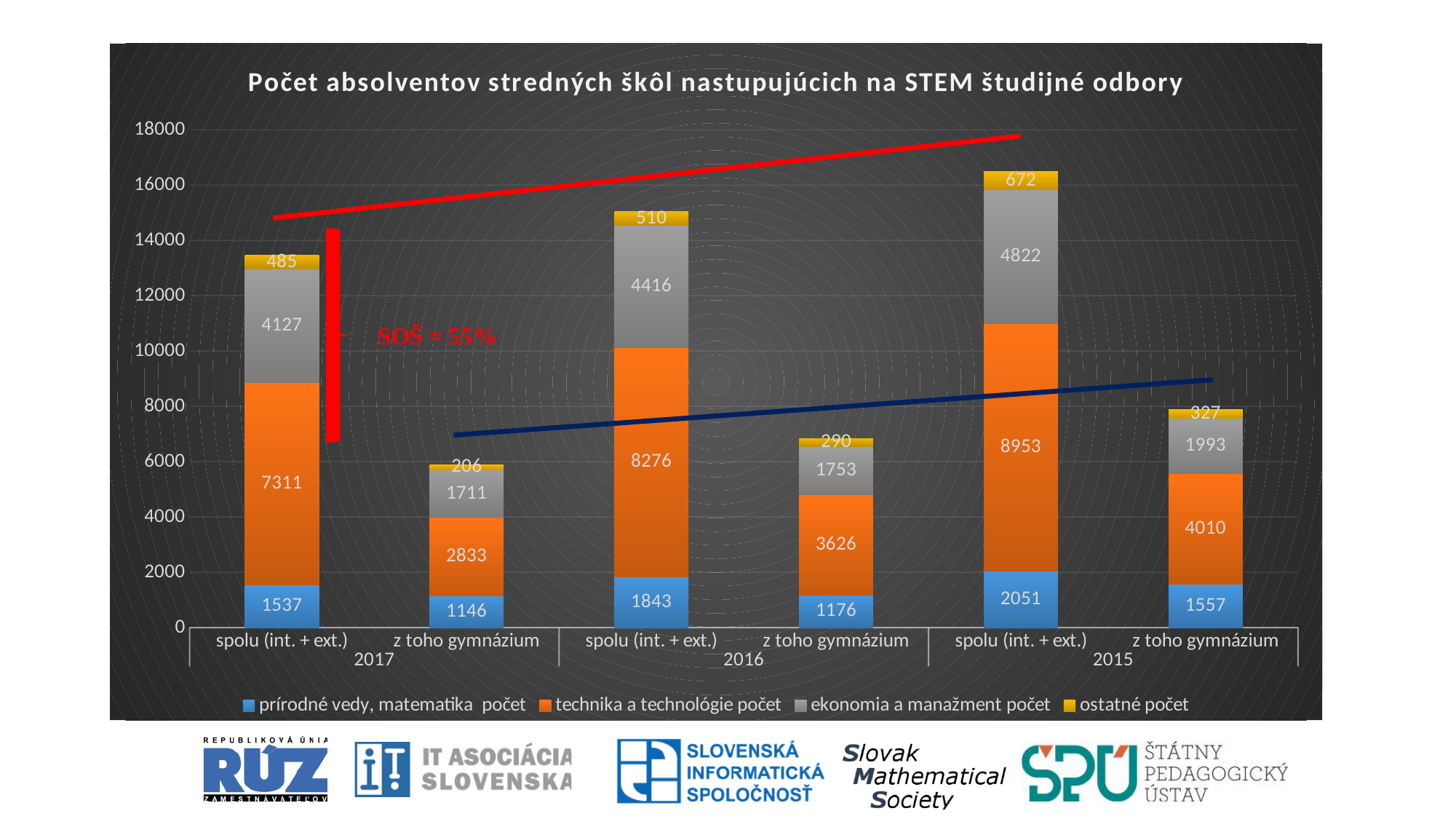
Which bar has the lowest total? z toho gymnázium 2017 Which is larger: 'ekonomia a manažment počet' for 'spolu (int. + ext.)' in 2017 or in 2016? 2016 Which bar has the highest total? spolu (int. + ext.) 2015 What is the difference between the 'technika a technológie počet' values for 'spolu (int. + ext.)' in 2015 and 2016? 677 What is the value of 'technika a technológie počet' for 'spolu (int. + ext.)' in 2017? 7311 How many series does the legend list? 4 What is the value of 'ekonomia a manažment počet' for 'z toho gymnázium' in 2016? 1753 What is the total of the 'spolu (int. + ext.)' bar for 2016? 15045 What type of chart is shown on the slide? stacked bar chart How many bars are plotted in the chart? 6 What is the value of 'ostatné počet' for 'spolu (int. + ext.)' in 2015? 672 What is the value of 'prírodné vedy, matematika počet' for 'z toho gymnázium' in 2015? 1557